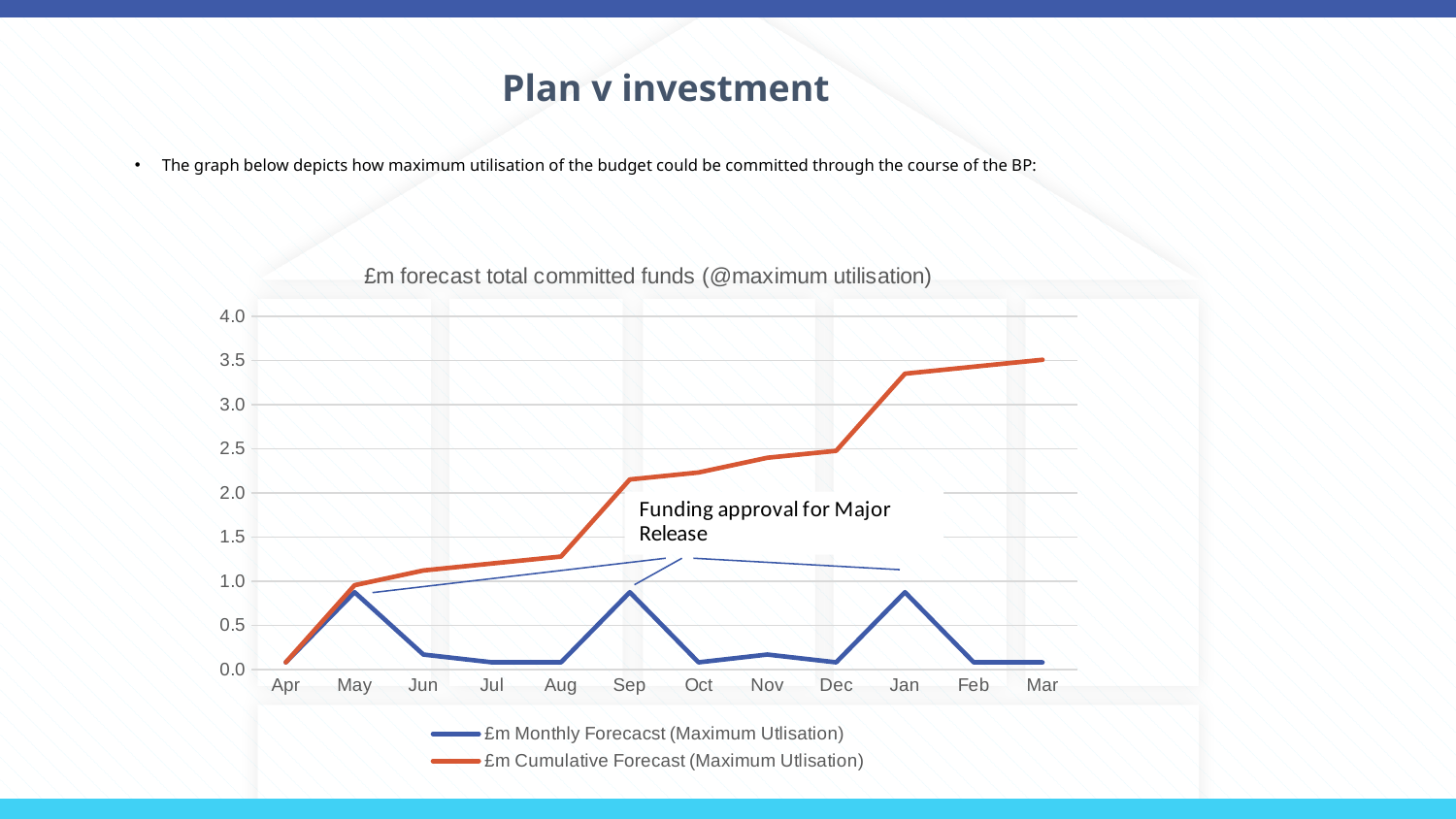
In which month is the £m Cumulative Forecast (Maximum Utlisation) value highest? Mar What is the title of the chart? £m forecast total committed funds (@maximum utilisation) Does the £m Cumulative Forecast (Maximum Utlisation) series rise or fall from Apr to Mar? rise Which series is drawn in orange? £m Cumulative Forecast (Maximum Utlisation) Is the £m Cumulative Forecast (Maximum Utlisation) value for Aug greater or less than 1.5? less What kind of chart is shown on the slide? line chart Is the £m Cumulative Forecast (Maximum Utlisation) value for Jan greater or less than 3.0? greater How many series does the legend list? 2 How many months are shown on the x axis? 12 Is the £m Monthly Forecacst (Maximum Utlisation) value for Jul greater or less than 0.5? less Which is larger, the £m Monthly Forecacst (Maximum Utlisation) value for Jun or for Sep? Sep In which month is the £m Cumulative Forecast (Maximum Utlisation) value lowest? Apr